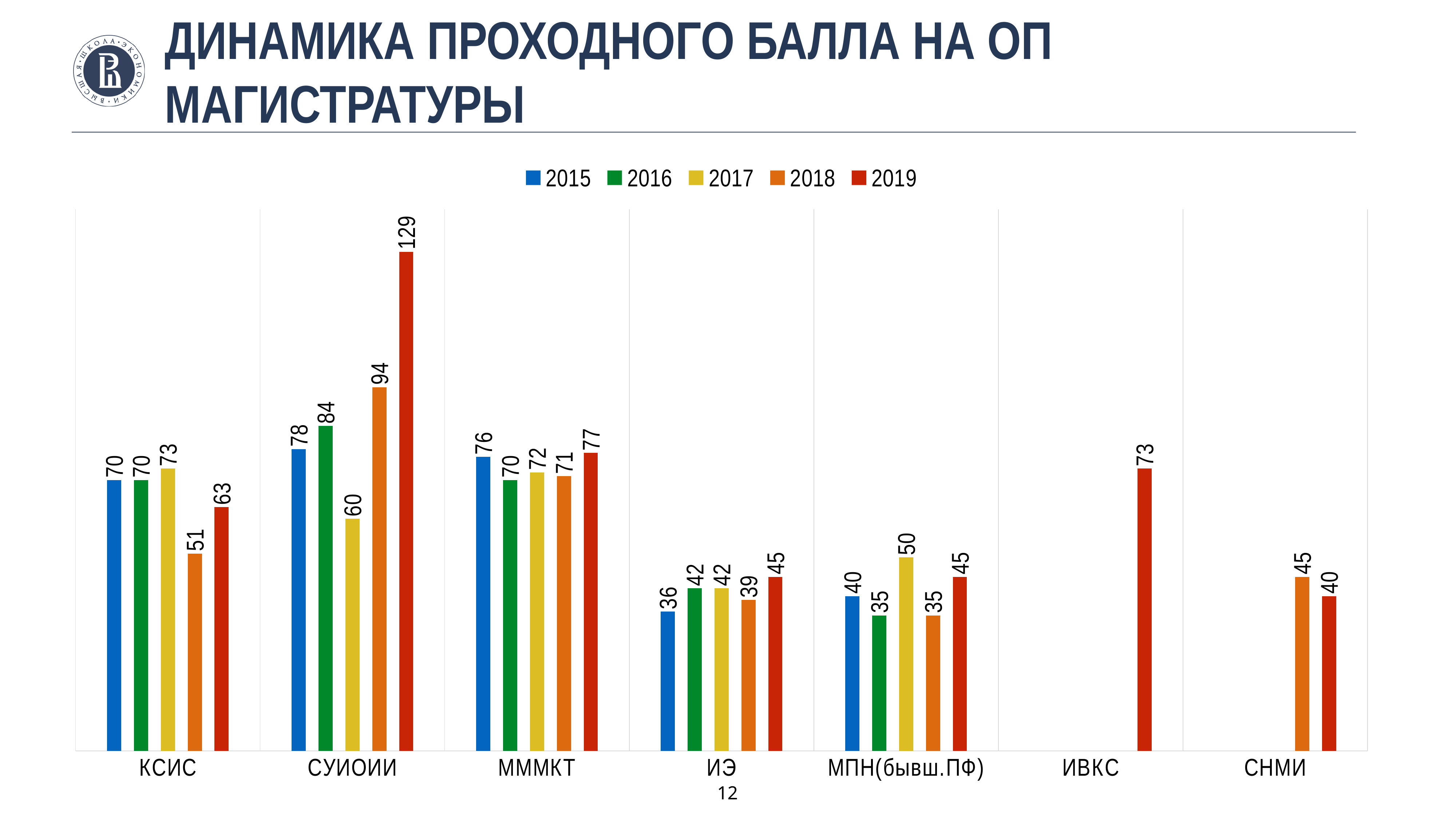
Do the values for СНМИ rise or fall from 2018 to 2019? fall How many categories are shown on the x axis? 7 What is the difference between the 2019 and 2018 values for СУИОИИ? 35 What is the value for СУИОИИ in 2019? 129 How many series does the legend list? 5 Which colour represents the 2016 series in the legend? green Which category has the lowest value in 2015? ИЭ What is the value for ИВКС in 2019? 73 Which category has the highest value in 2019? СУИОИИ What is the value for КСИС in 2018? 51 Which is larger for МПН(бывш.ПФ): the 2017 value or the 2018 value? 2017 What kind of chart is shown on the slide? bar chart